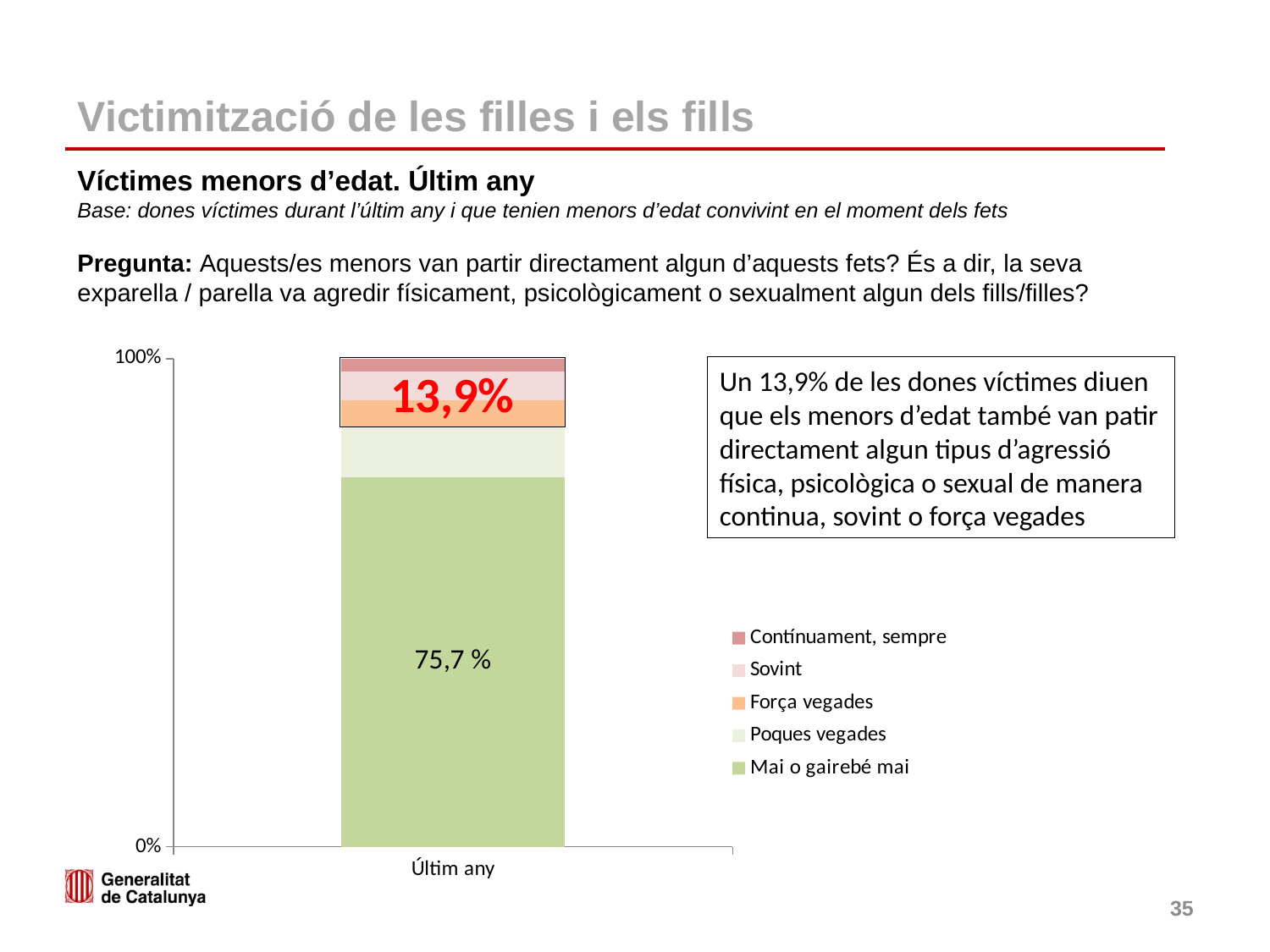
What combined percentage is printed for the top three segments (Contínuament, sempre; Sovint; Força vegades) of the bar? 13,9% How many categories are plotted on the x axis? 1 Is the value for 'Poques vegades' greater or less than 20%? less What is the category label on the x axis of the chart? Últim any How many series does the legend list? 5 Which is larger, the 'Mai o gairebé mai' segment or the 'Poques vegades' segment? Mai o gairebé mai What is the value shown for 'Mai o gairebé mai' in the 'Últim any' bar? 75,7 % Is the value for 'Mai o gairebé mai' greater or less than 50%? greater What kind of chart is shown on the slide? Stacked bar chart What is the first entry listed in the chart legend? Contínuament, sempre Which segment of the 'Últim any' bar is the largest? Mai o gairebé mai What is the difference between the 'Mai o gairebé mai' value (75,7 %) and the combined 13,9% of the top three segments? 61,8 %